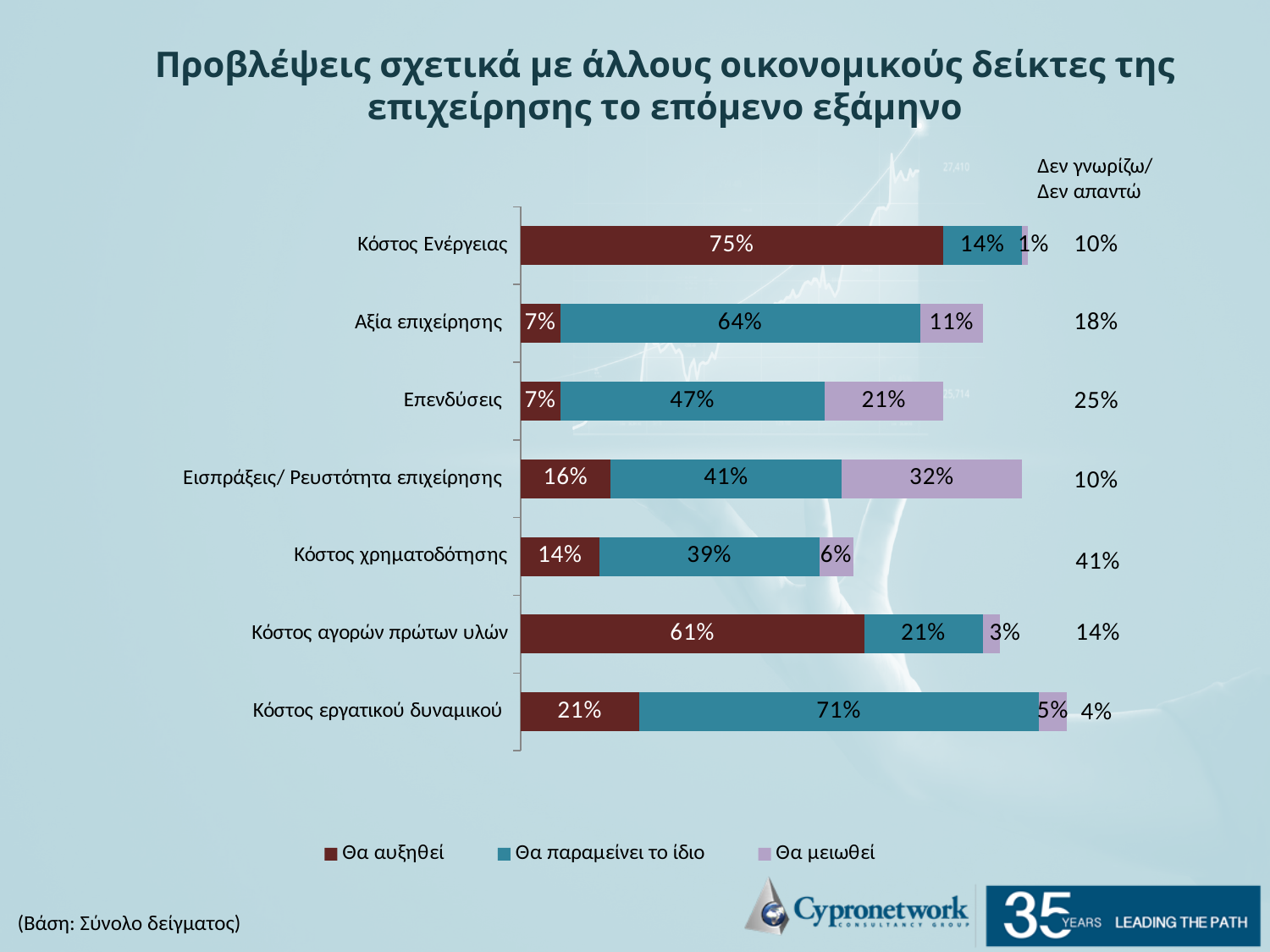
How many categories are shown on the chart? 7 What percentage of respondents expect Κόστος Ενέργειας to increase (Θα αυξηθεί)? 75% What is the value of Θα παραμείνει το ίδιο for Κόστος εργατικού δυναμικού? 71% Which category has the lowest Θα μειωθεί value? Κόστος Ενέργειας Which is larger: the Θα παραμείνει το ίδιο value for Αξία επιχείρησης or for Επενδύσεις? Αξία επιχείρησης What is the Δεν γνωρίζω/ Δεν απαντώ percentage for Κόστος χρηματοδότησης? 41% What is the difference between the Θα αυξηθεί values for Κόστος Ενέργειας and Κόστος αγορών πρώτων υλών? 14% How many series does the legend list? 3 What is the Θα μειωθεί value for Εισπράξεις/ Ρευστότητα επιχείρησης? 32% What is the total of the three stacked segments for Κόστος αγορών πρώτων υλών? 85% What kind of chart is shown on the slide? Stacked bar chart Which category has the highest Θα αυξηθεί value? Κόστος Ενέργειας